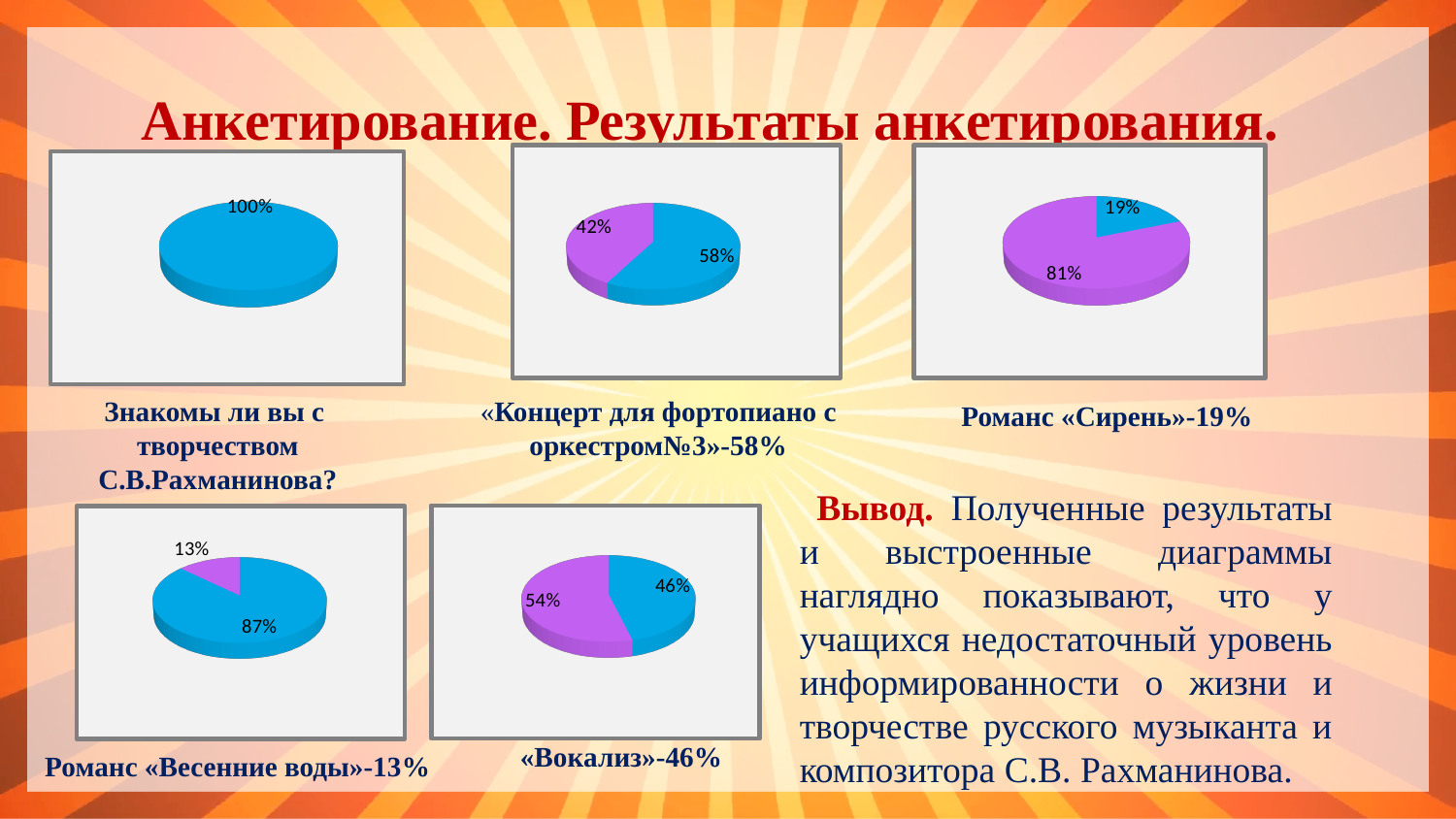
In the top-left pie chart (Знакомы ли вы с творчеством С.В.Рахманинова?), what percentage is shown? 100% In the pie chart for Романс «Весенние воды», what is the difference between the blue slice and the purple slice? 74% How many slices does the pie chart for Романс «Сирень» have? 2 What kind of chart is used for the «Вокализ» results on the slide? pie chart In the pie chart for «Вокализ», what share does the purple slice have? 54% In the pie chart for Романс «Сирень», what share does the purple slice have? 81% How many pie charts are shown on the slide? 5 In the pie chart for Романс «Весенние воды», what share does the blue slice have? 87% In the pie chart for Романс «Сирень», which slice is larger, the blue one or the purple one? the purple one In the pie chart for «Вокализ», what is the difference between the purple slice and the blue slice? 8% In the pie chart for «Концерт для фортопиано с оркестром№3», what share does the blue slice have? 58% In the pie chart for «Концерт для фортопиано с оркестром№3», what share does the purple slice have? 42%